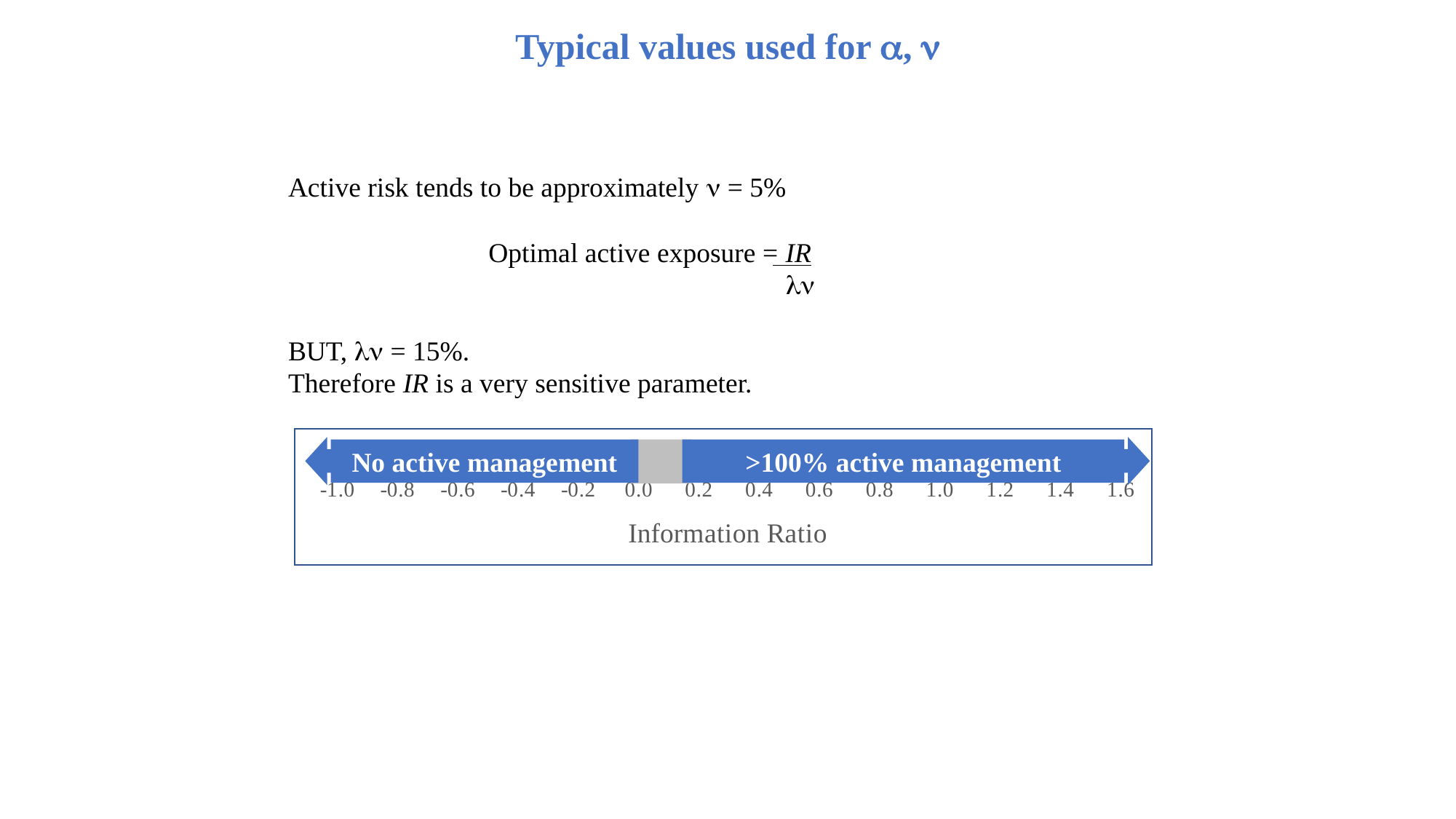
Does the '>100% active management' region lie at Information Ratio values greater or less than 0.0? greater What label is printed on the right-hand blue arrow of the Information Ratio diagram? >100% active management Is the grey gap between the two blue arrows located at Information Ratio values greater or less than 0.2? less Does the 'No active management' region lie at Information Ratio values greater or less than 0.0? less What is the label of the horizontal axis in the diagram at the bottom of the slide? Information Ratio How many tick labels are shown along the Information Ratio axis? 14